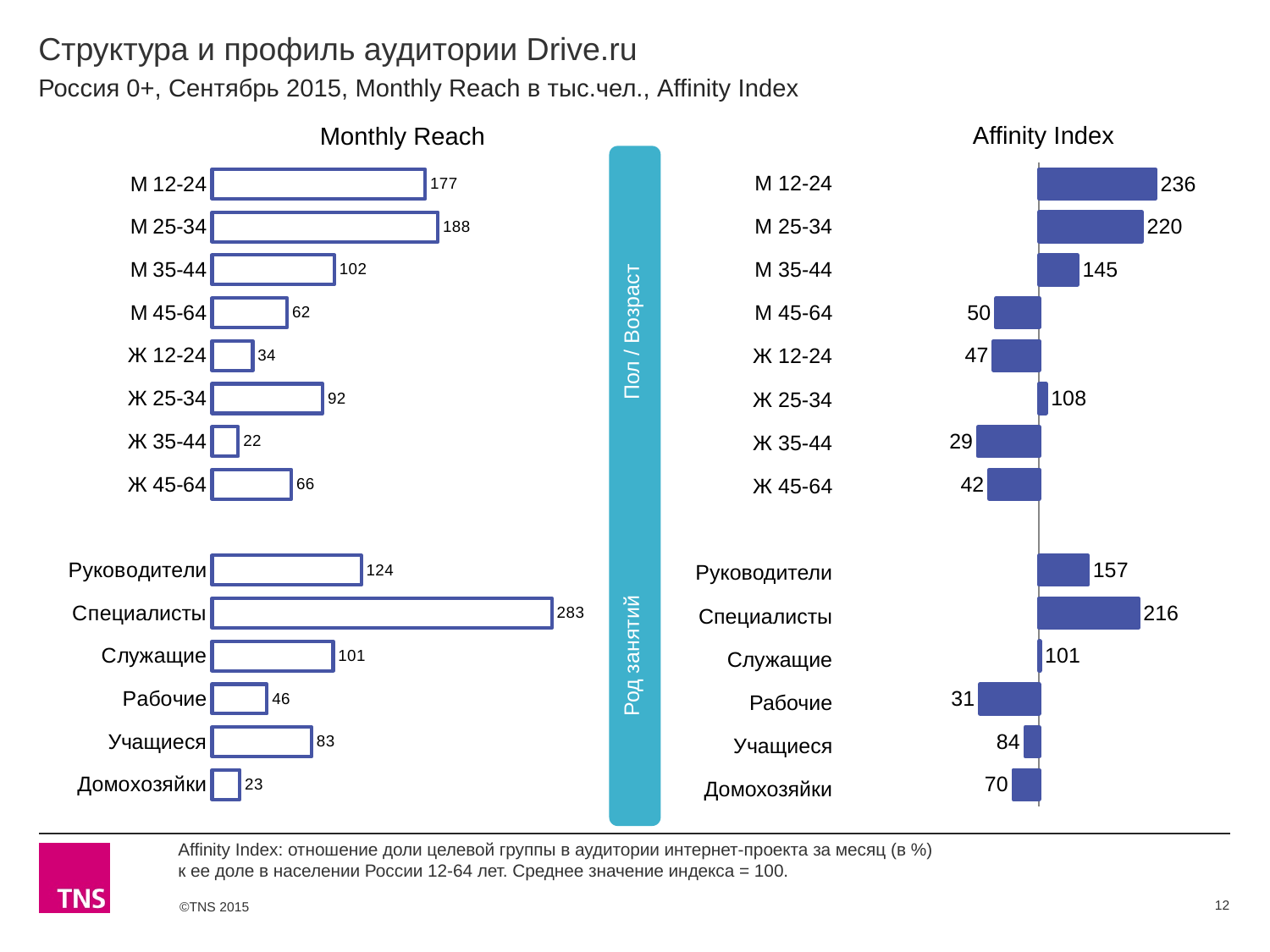
How many categories are plotted in the Affinity Index chart? 14 In the Affinity Index chart, what is the value for М 12-24? 236 In the Affinity Index chart, which is larger: Учащиеся or Домохозяйки? Учащиеся In the Monthly Reach chart, which is larger: Руководители or Служащие? Руководители In the Monthly Reach chart, which category has the highest value? Специалисты In the Affinity Index chart, which category has the lowest value? Ж 35-44 In the Affinity Index chart, what is the difference between М 12-24 and М 25-34? 16 In the Affinity Index chart, what is the value for Рабочие? 31 In the Monthly Reach chart, what is the difference between М 25-34 and М 12-24? 11 What kind of chart is the Monthly Reach chart? Bar chart In the Monthly Reach chart, which category has the lowest value? Ж 35-44 In the Monthly Reach chart, what is the value for Специалисты? 283